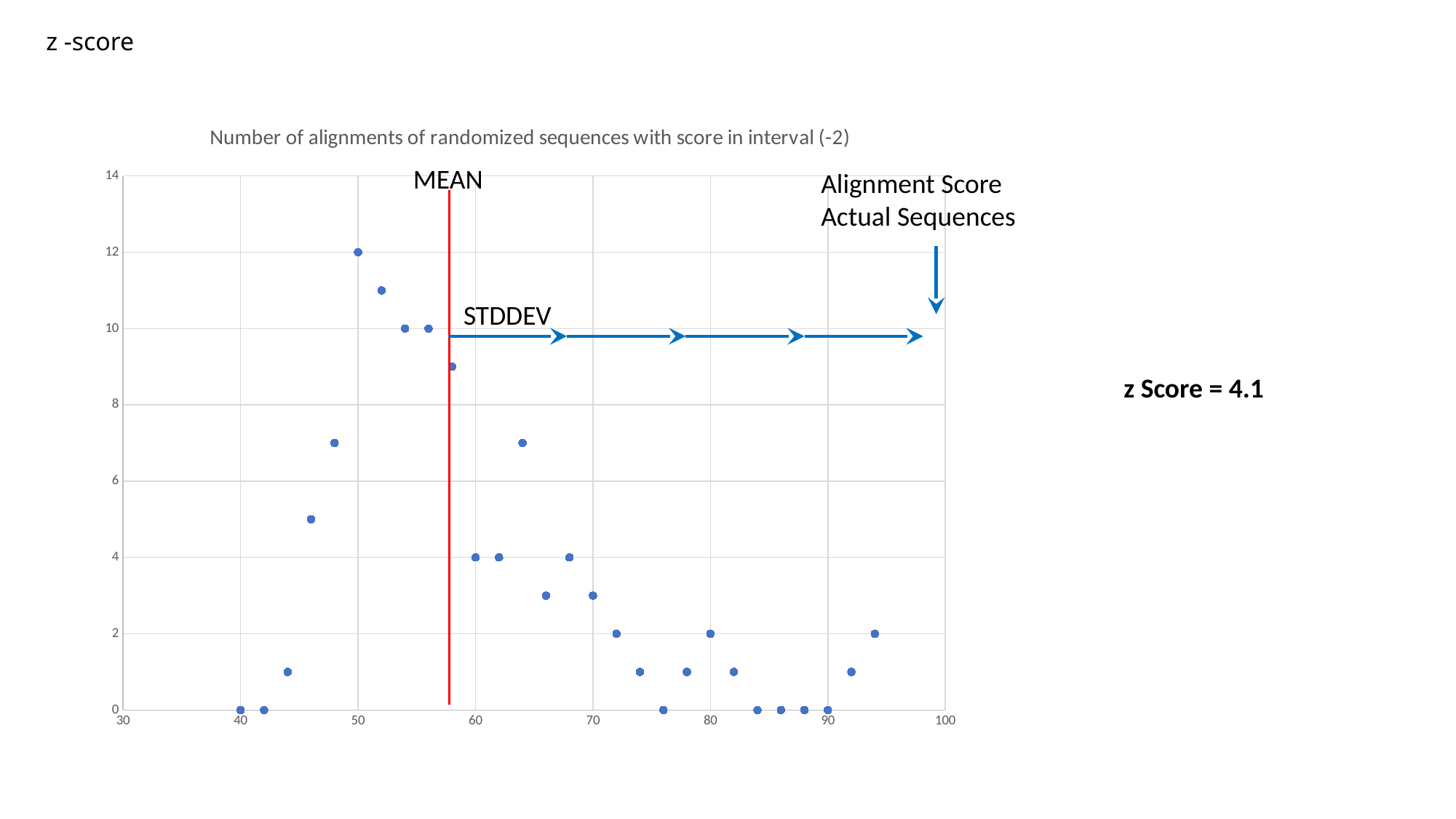
Is the y value of the point at x = 48 greater or less than 6? greater What is the title of the chart? Number of alignments of randomized sequences with score in interval (-2) Which point has the larger y value, the one at x = 50 or the one at x = 60? x = 50 What kind of chart is shown on the slide? Scatter chart What is the y value of the point at x = 60? 4 Is the y value of the point at x = 74 greater or less than 2? less What is the y value of the point at x = 80? 2 At which x value does the highest point occur? 50 What colour is the vertical line labelled MEAN? Red What is the y value of the point at x = 50? 12 Do the y values generally rise or fall as x increases from 60 to 90? fall What is the y value of the point at x = 90? 0